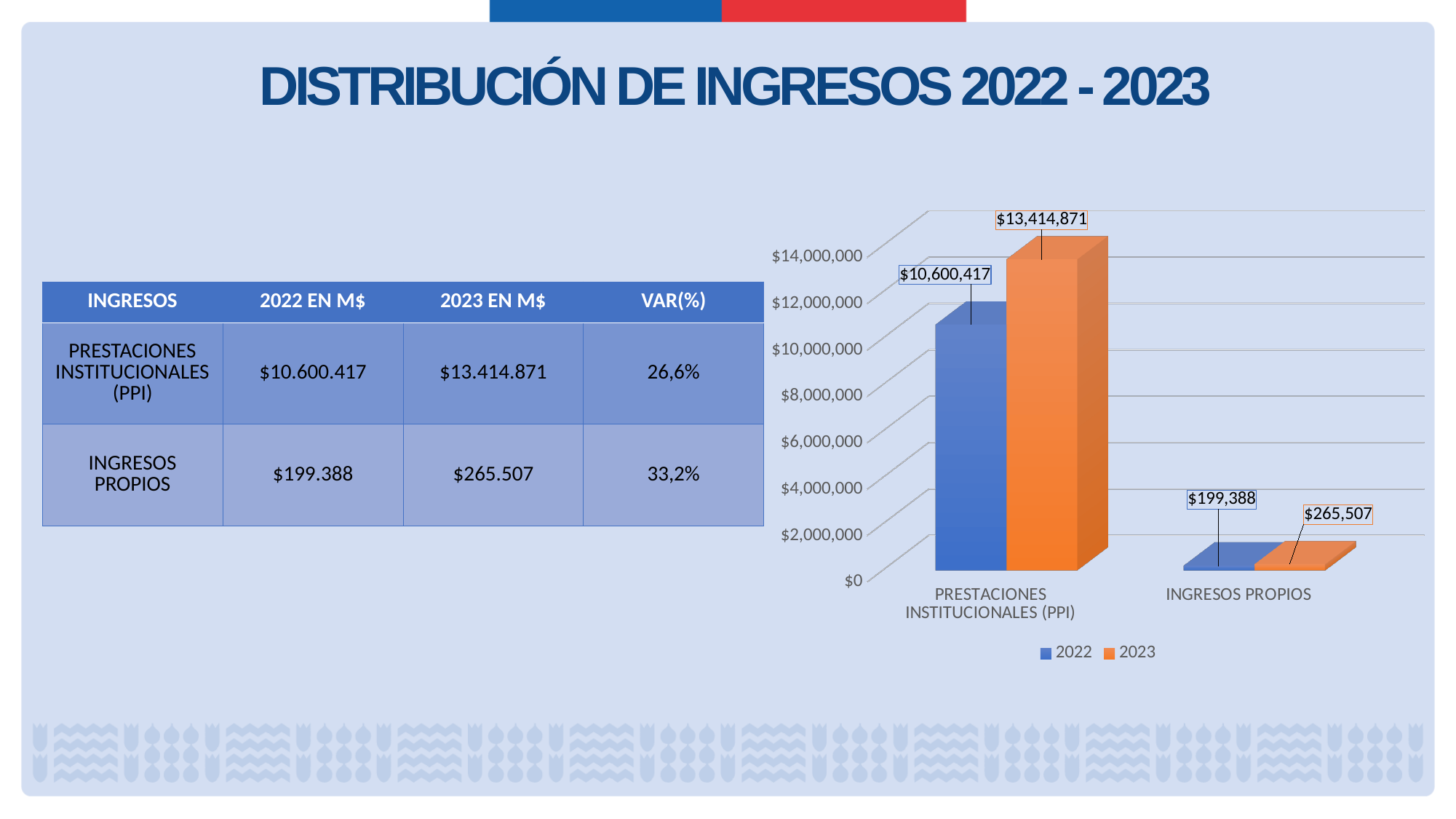
Which category has the lowest 2022 value in the chart? INGRESOS PROPIOS Which category has the highest 2023 value in the chart? PRESTACIONES INSTITUCIONALES (PPI) Is the 2023 value for PRESTACIONES INSTITUCIONALES (PPI) greater or less than $14,000,000? less For INGRESOS PROPIOS, which is larger: the 2022 value or the 2023 value? 2023 How many series does the chart legend list? 2 What is the 2023 value for INGRESOS PROPIOS in the chart? $265,507 What is the 2022 value for INGRESOS PROPIOS in the chart? $199,388 What is the 2022 value for PRESTACIONES INSTITUCIONALES (PPI) in the chart? $10,600,417 What is the difference between the 2023 and 2022 values for PRESTACIONES INSTITUCIONALES (PPI)? $2,814,454 What is the 2023 value for PRESTACIONES INSTITUCIONALES (PPI) in the chart? $13,414,871 What kind of chart is shown on the slide? bar chart What is the difference between the 2023 and 2022 values for INGRESOS PROPIOS? $66,119